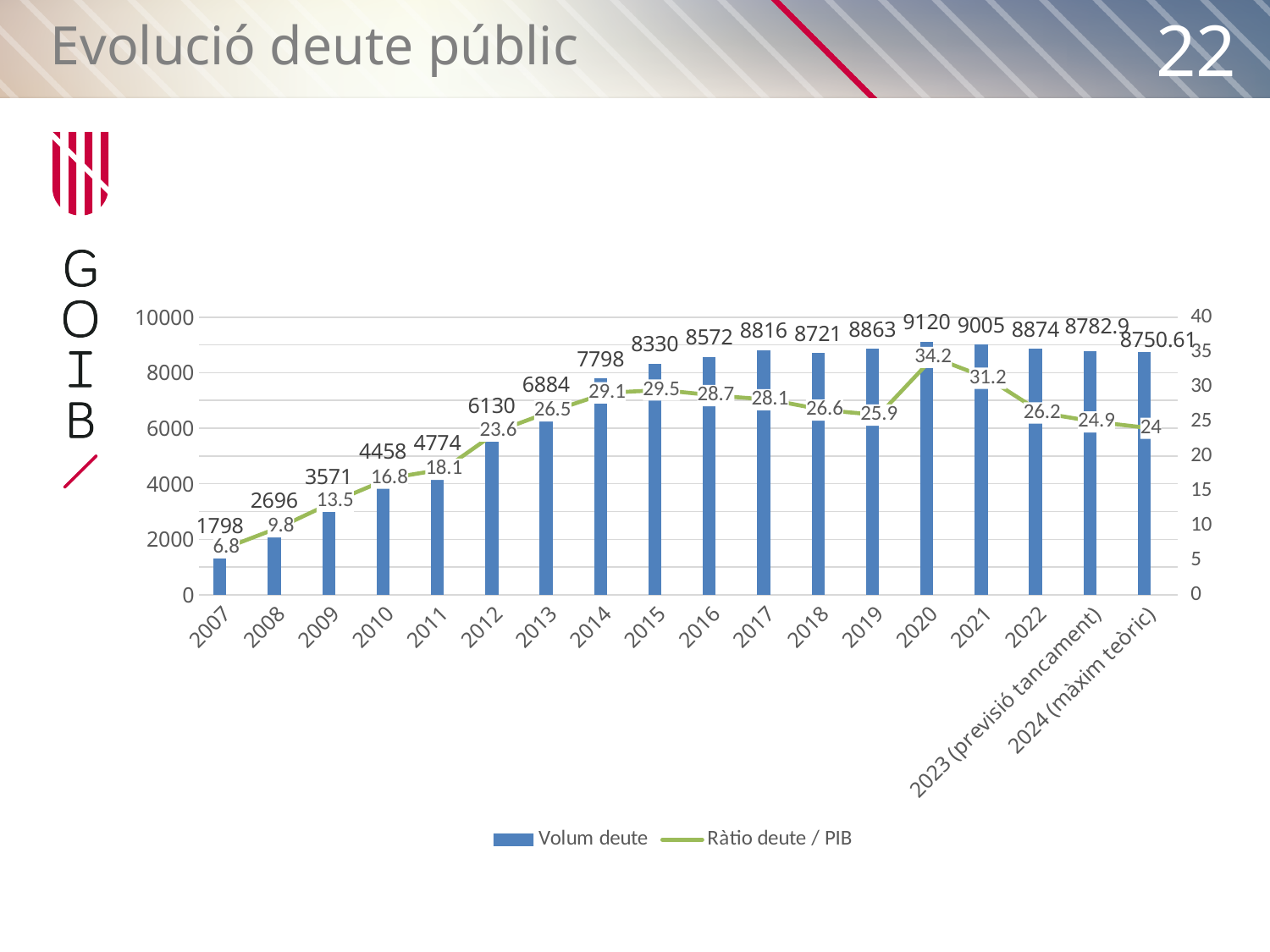
What is the Volum deute value for 2024 (màxim teòric)? 8750.61 Is the Volum deute for 2012 greater or less than 6000? greater How many series does the legend list? 2 What is the difference in Volum deute between 2021 and 2022? 131 Which year has the highest Volum deute? 2020 Which is larger, the Ràtio deute / PIB for 2015 or for 2016? 2015 What kind of chart is used for the Volum deute series? bar chart What is the Volum deute value for 2014? 7798 What is the Ràtio deute / PIB value for 2020? 34.2 How many categories are shown on the x axis? 18 Which year has the lowest Ràtio deute / PIB? 2007 Does the Ràtio deute / PIB rise or fall from 2021 to 2024 (màxim teòric)? fall